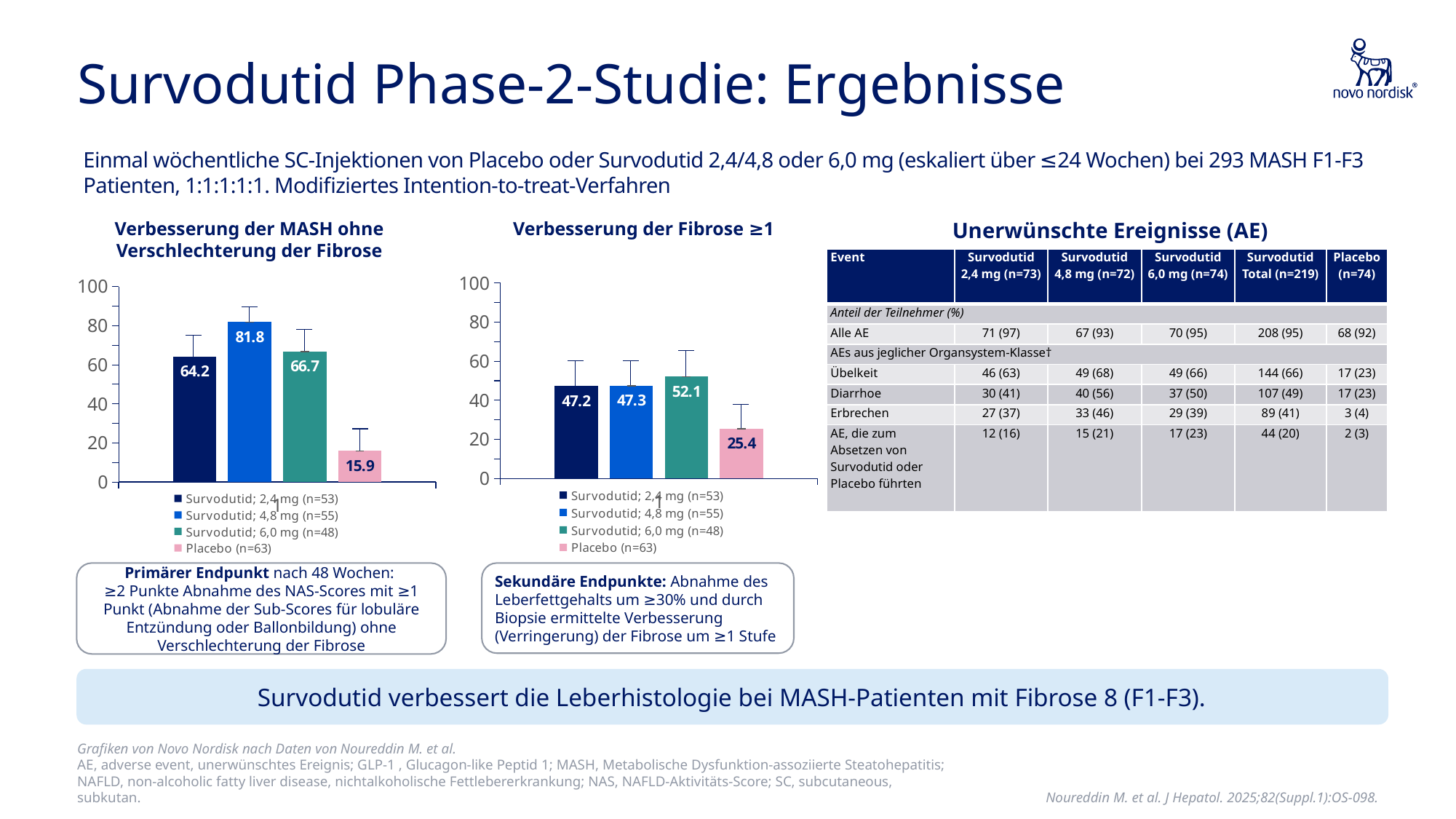
In the chart 'Verbesserung der MASH ohne Verschlechterung der Fibrose', what is the value for Placebo (n=63)? 15.9 What kind of chart is 'Verbesserung der MASH ohne Verschlechterung der Fibrose'? Bar chart In the chart 'Verbesserung der Fibrose ≥1', is the value for Survodutid 2,4 mg greater or less than 40? greater In the chart 'Verbesserung der MASH ohne Verschlechterung der Fibrose', what is the difference between the Survodutid 4,8 mg and Placebo values? 65.9 In the chart 'Verbesserung der Fibrose ≥1', which series has the lowest value? Placebo (n=63) How many series does the legend of the chart 'Verbesserung der Fibrose ≥1' list? 4 In the chart 'Verbesserung der MASH ohne Verschlechterung der Fibrose', which is larger: the value for Survodutid 2,4 mg or Survodutid 6,0 mg? Survodutid; 6,0 mg (n=48) In the chart 'Verbesserung der MASH ohne Verschlechterung der Fibrose', what is the value for Survodutid 4,8 mg (n=55)? 81.8 In the chart 'Verbesserung der MASH ohne Verschlechterung der Fibrose', which series has the highest value? Survodutid; 4,8 mg (n=55) In the chart 'Verbesserung der Fibrose ≥1', what is the value for Survodutid 6,0 mg (n=48)? 52.1 In the chart 'Verbesserung der Fibrose ≥1', what is the value for Placebo (n=63)? 25.4 In the chart 'Verbesserung der Fibrose ≥1', what is the difference between the Survodutid 6,0 mg and Placebo values? 26.7